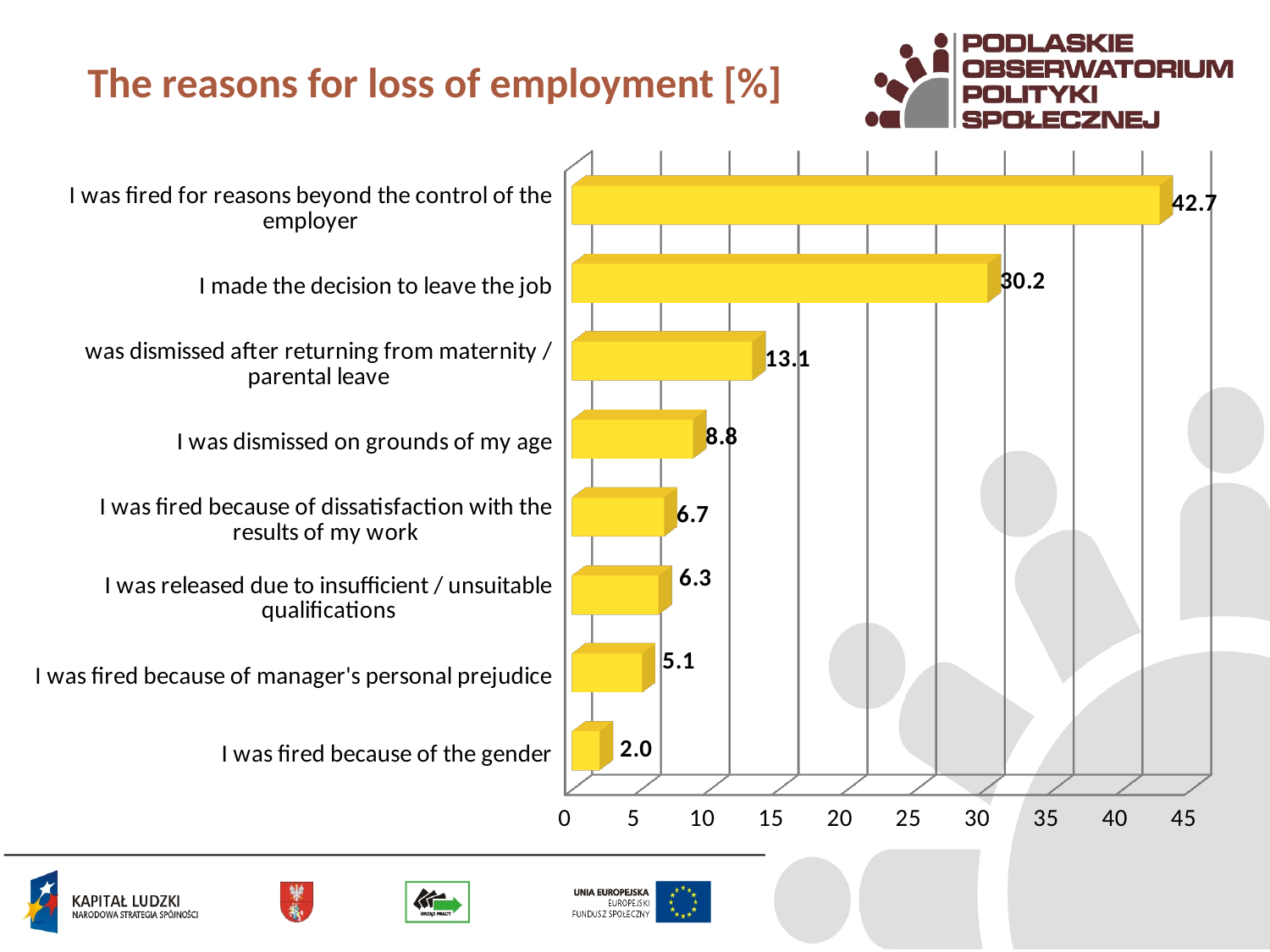
Is the value for "was dismissed after returning from maternity / parental leave" greater or less than 10? greater What is the difference between the values for "I was fired for reasons beyond the control of the employer" and "I made the decision to leave the job"? 12.5 Which is larger: the value for "I was fired because of dissatisfaction with the results of my work" or "I was released due to insufficient / unsuitable qualifications"? I was fired because of dissatisfaction with the results of my work What is the value for "I was fired because of the gender"? 2.0 Which reason has the lowest value? I was fired because of the gender What kind of chart is shown on the slide? Bar chart What is the value for "I was fired for reasons beyond the control of the employer"? 42.7 Which reason has the highest value? I was fired for reasons beyond the control of the employer What is the value for "I was dismissed on grounds of my age"? 8.8 What is the title of the chart? The reasons for loss of employment [%] How many reasons (categories) are shown in the chart? 8 What is the value for "I made the decision to leave the job"? 30.2